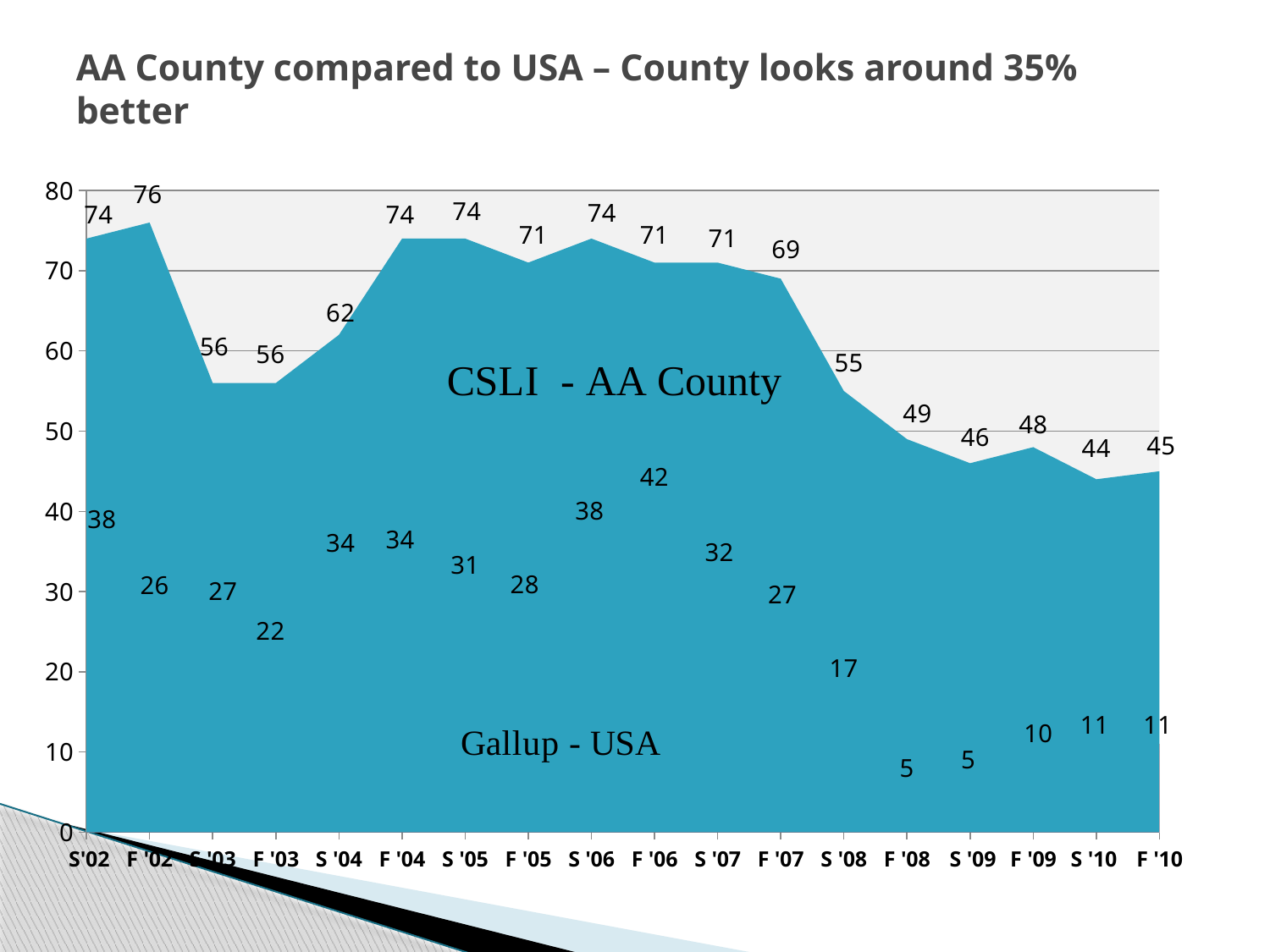
What is the CSLI - AA County value for F '10? 45 What is the title of the slide? AA County compared to USA – County looks around 35% better How many periods are shown on the x axis? 18 What is the difference between the CSLI - AA County value and the Gallup - USA value for S '08? 38 What kind of chart is shown on the slide? Area chart Do the CSLI - AA County values rise or fall from F '07 to F '10? Fall What is the CSLI - AA County value for F '02? 76 Which period has the highest CSLI - AA County value? F '02 Which is larger, the Gallup - USA value for S '06 or for F '07? S '06 How many data series are plotted on the chart? 2 What is the Gallup - USA value for F '06? 42 What is the lowest Gallup - USA value shown on the chart? 5